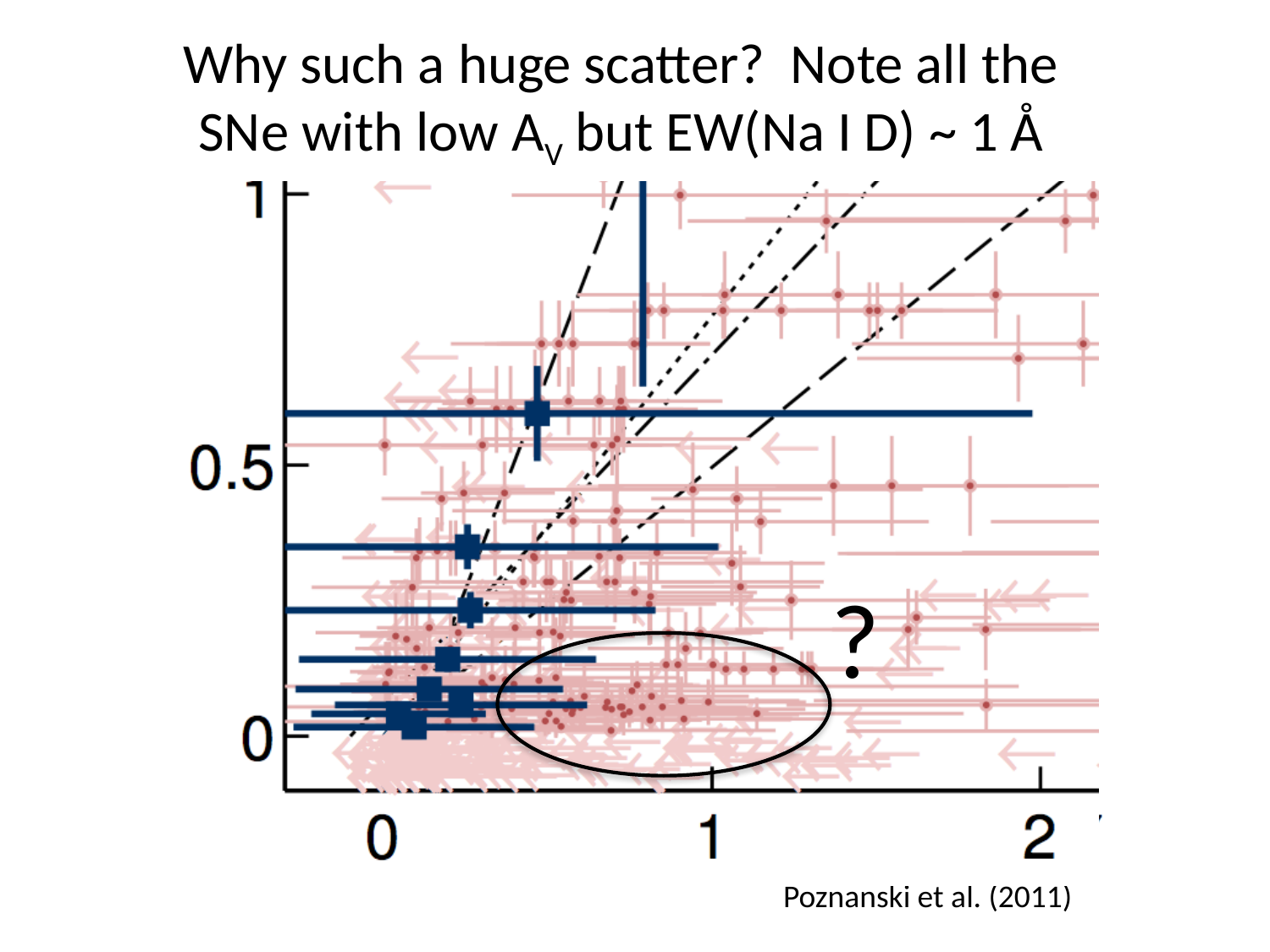
Which publication is the chart credited to? Poznanski et al. (2011) What kind of chart is shown on the slide? scatter plot Is the x value of the highest dark blue square greater or less than 1? less What is the largest tick label shown on the x axis? 2 Are the points inside the black ellipse above or below 0.5 on the y axis? below Is the y value of the lowest dark blue square greater or less than 0.5? less